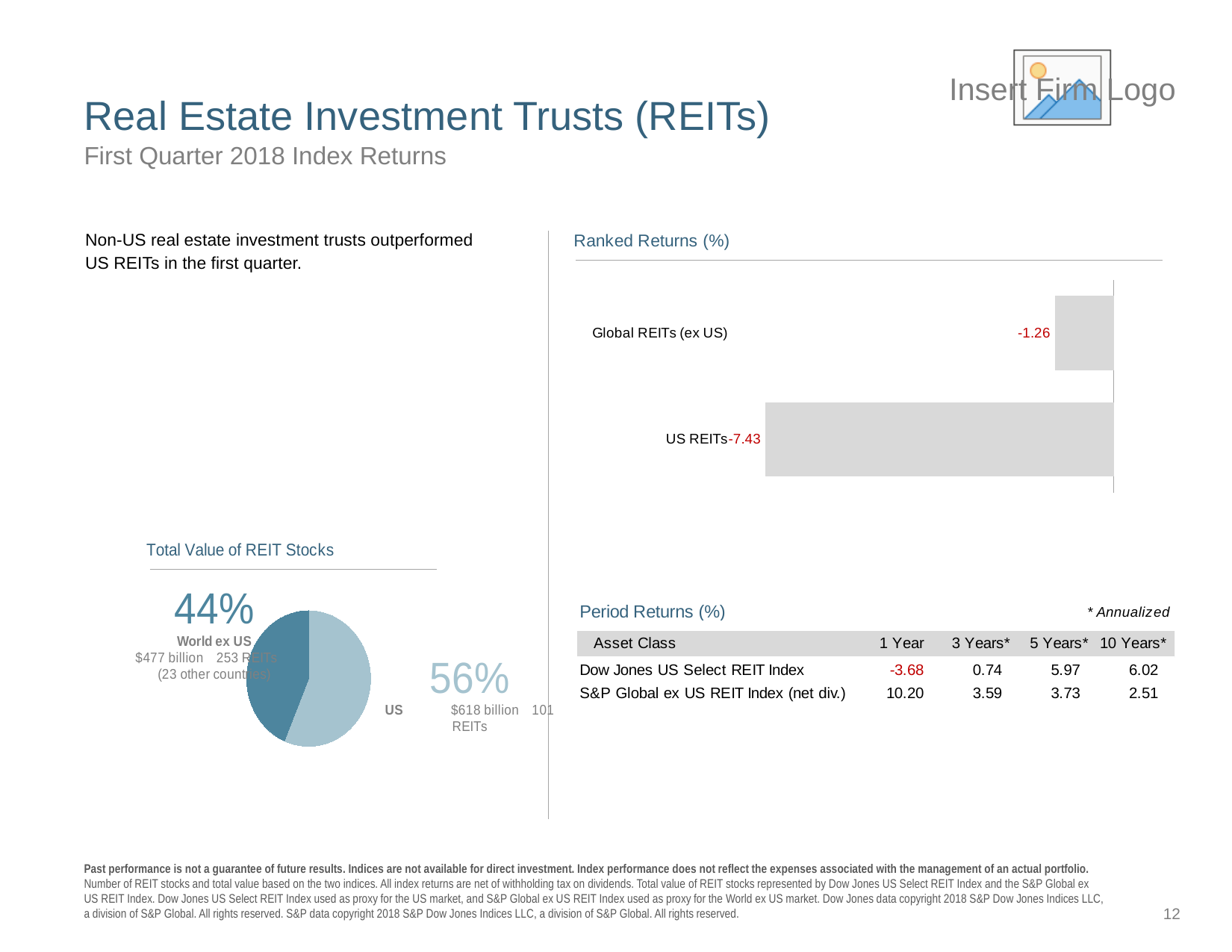
What kind of chart is the Ranked Returns (%) chart? Bar chart In the Ranked Returns (%) chart, which category has the lowest value? US REITs In the Ranked Returns (%) chart, which category has the highest value? Global REITs (ex US) In the Ranked Returns (%) chart, what is the difference between the Global REITs (ex US) value and the US REITs value? 6.17 How many categories are shown in the Ranked Returns (%) chart? 2 In the Total Value of REIT Stocks chart, what share of the pie is World ex US? 44% In the Ranked Returns (%) chart, which is larger, the value for Global REITs (ex US) or the value for US REITs? Global REITs (ex US) In the Ranked Returns (%) chart, what is the value for Global REITs (ex US)? -1.26 In the Ranked Returns (%) chart, what is the value for US REITs? -7.43 What kind of chart is the Total Value of REIT Stocks chart? Pie chart In the Total Value of REIT Stocks chart, what share of the pie is US? 56% In the Total Value of REIT Stocks chart, which slice is larger, US or World ex US? US